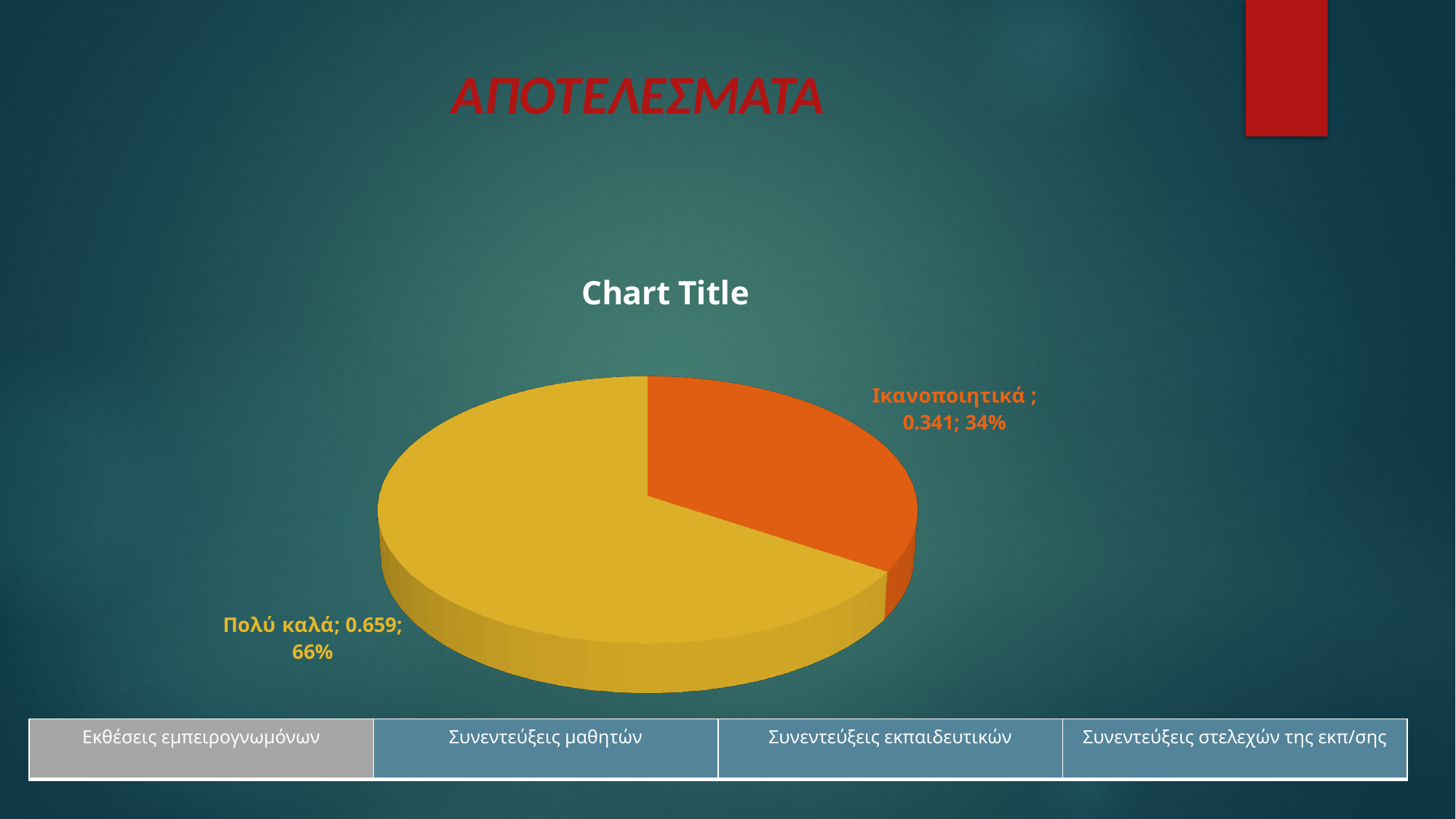
Which slice is the smallest in the pie chart? Ικανοποιητικά What value is shown for the slice labelled Ικανοποιητικά? 0.341 What value is shown for the slice labelled Πολύ καλά? 0.659 How many slices does the pie chart have? 2 What is the title of the chart? Chart Title Which slice is the largest in the pie chart? Πολύ καλά Which is larger, the Πολύ καλά slice or the Ικανοποιητικά slice? Πολύ καλά What percentage share of the pie does the Πολύ καλά slice have? 66% What colour is the Ικανοποιητικά slice? orange What kind of chart is shown on the slide? pie chart What percentage share of the pie does the Ικανοποιητικά slice have? 34% What is the difference in percentage points between the Πολύ καλά share and the Ικανοποιητικά share? 32%